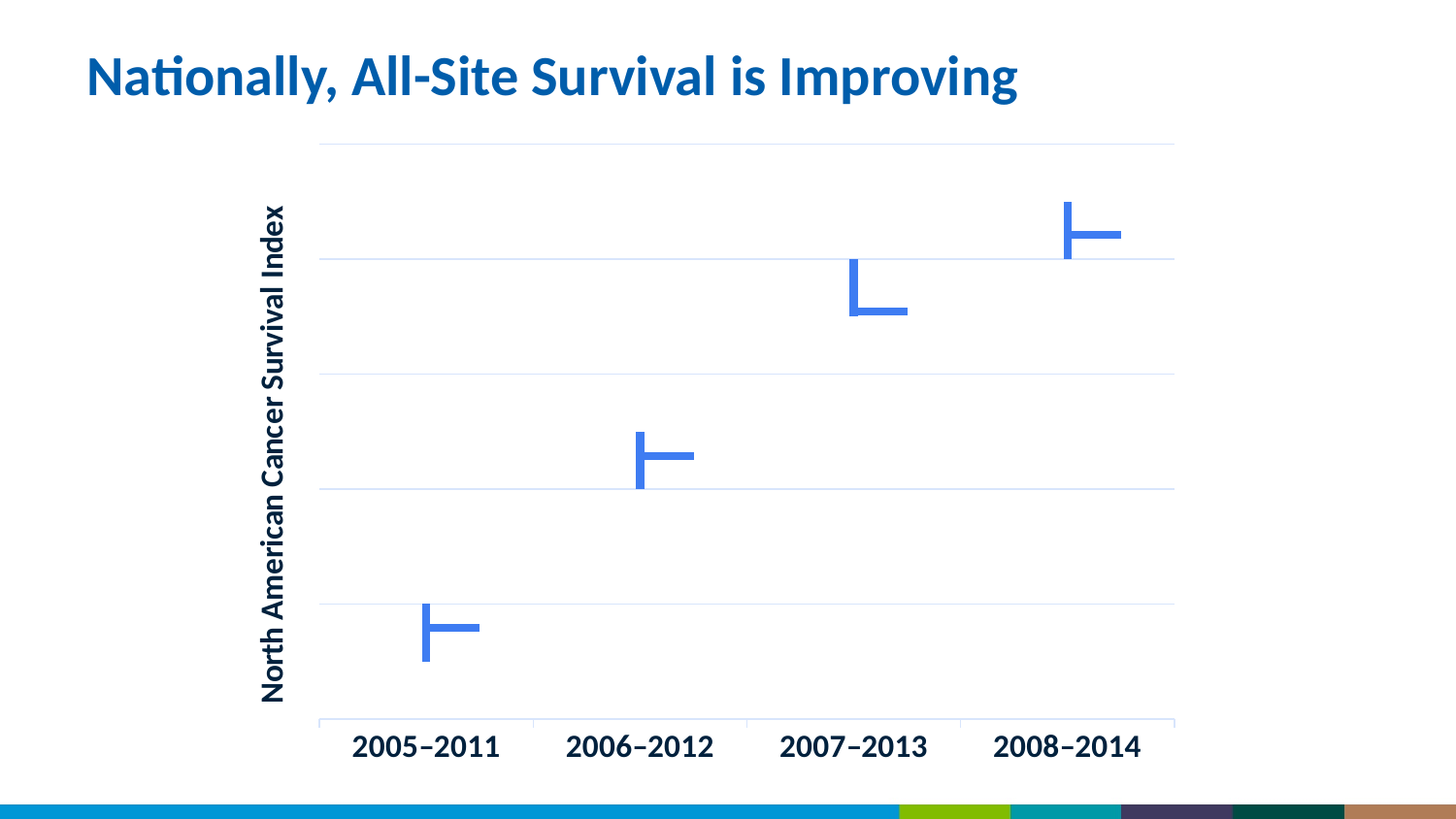
Which is higher on the chart, 2005–2011 or 2008–2014? 2008–2014 Which is higher on the chart, 2005–2011 or 2006–2012? 2006–2012 Which time period has the lowest value on the chart? 2005–2011 Do the values rise or fall from 2005–2011 to 2008–2014? rise What is the title of the slide containing the chart? Nationally, All-Site Survival is Improving How many time periods are shown along the x axis of the chart? 4 Which time period has the highest value on the chart? 2008–2014 Which is higher on the chart, 2006–2012 or 2007–2013? 2007–2013 What is the label on the vertical axis of the chart? North American Cancer Survival Index